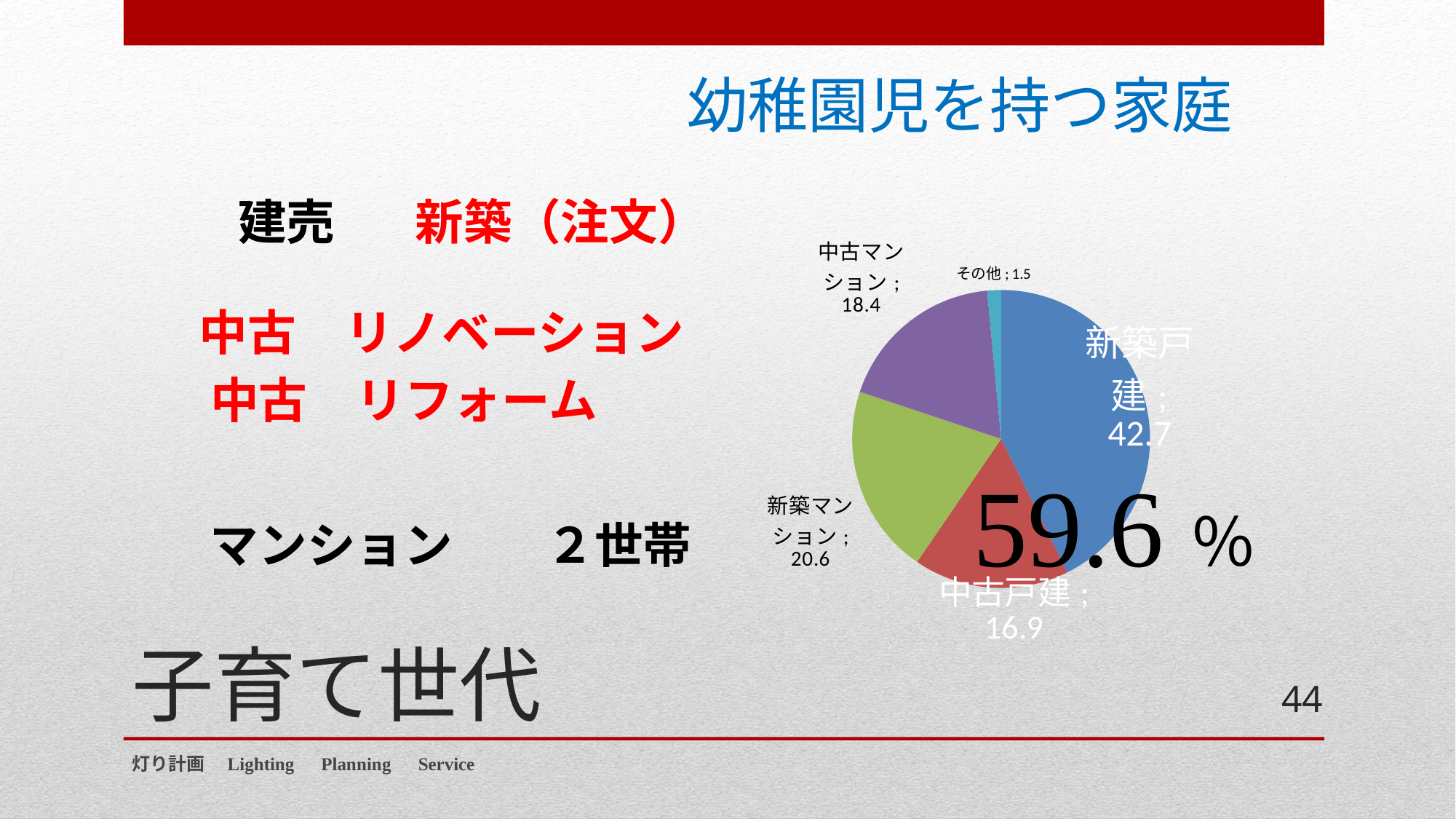
Which slice of the pie chart is the largest? 新築戸建 What kind of chart is shown on the slide? pie chart What is the value shown for その他 in the pie chart? 1.5 What is the value shown for 中古戸建 in the pie chart? 16.9 What colour is the 新築戸建 slice in the pie chart? blue What is the value shown for 新築戸建 in the pie chart? 42.7 Which slice of the pie chart is the smallest? その他 How many slices does the pie chart have? 5 Which is larger in the pie chart, 新築マンション or 中古マンション? 新築マンション What is the value shown for 中古マンション in the pie chart? 18.4 What is the difference between the values for 新築戸建 and 中古戸建 in the pie chart? 25.8 What is the value shown for 新築マンション in the pie chart? 20.6